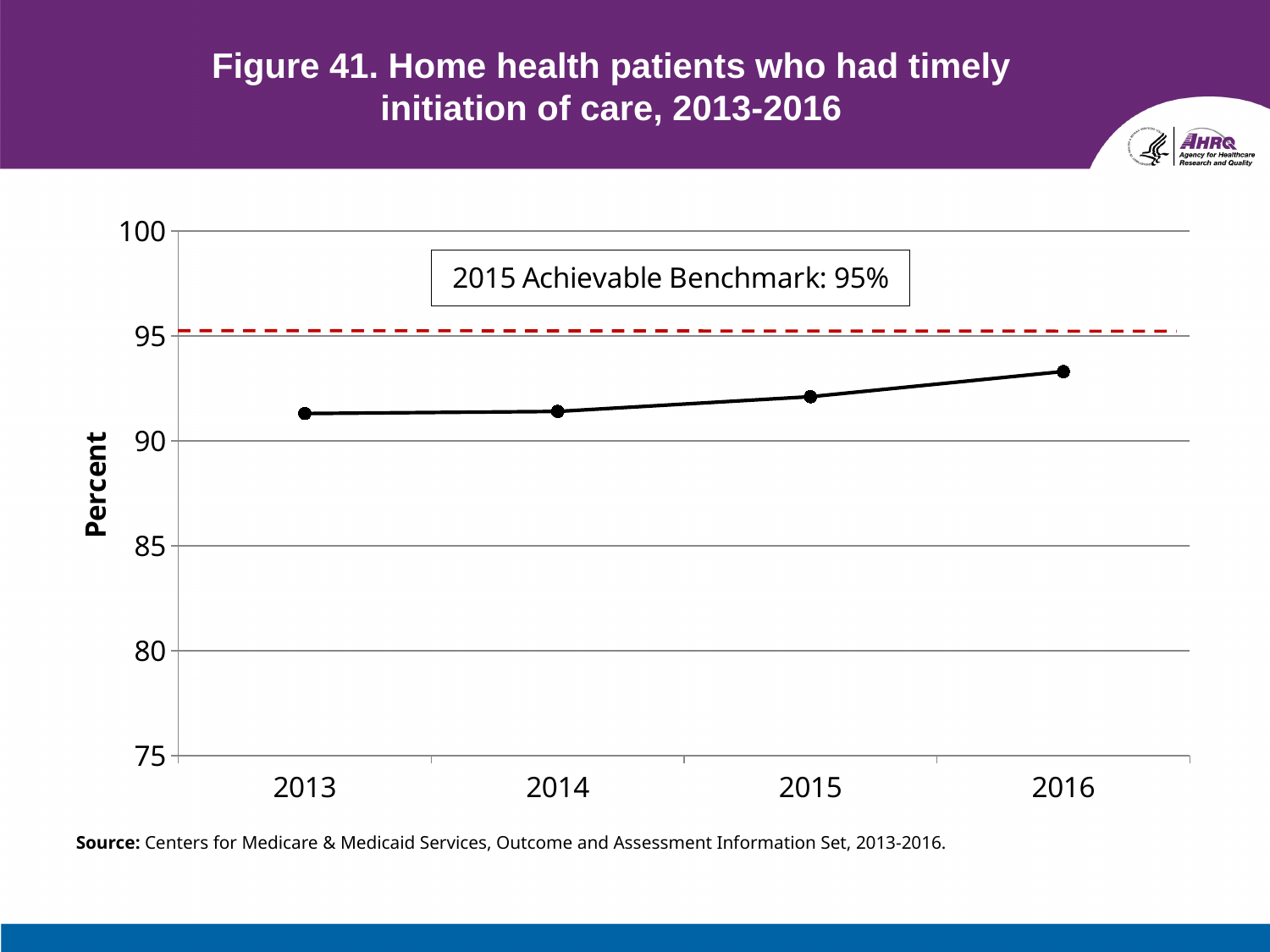
Is the value for 2014 greater or less than 95? less Do the plotted values rise or fall from 2013 to 2016? rise What is the label on the y axis? Percent Which is larger, the value for 2016 or the value for 2013? 2016 Is the value for 2013 greater or less than 90? greater Is the value for 2016 greater or less than 95? less What kind of chart is shown on the slide? line chart How many years are plotted on the x axis? 4 Which is larger, the value for 2015 or the value for 2013? 2015 Which year has the highest plotted value? 2016 What is the 2015 Achievable Benchmark shown on the chart? 95%